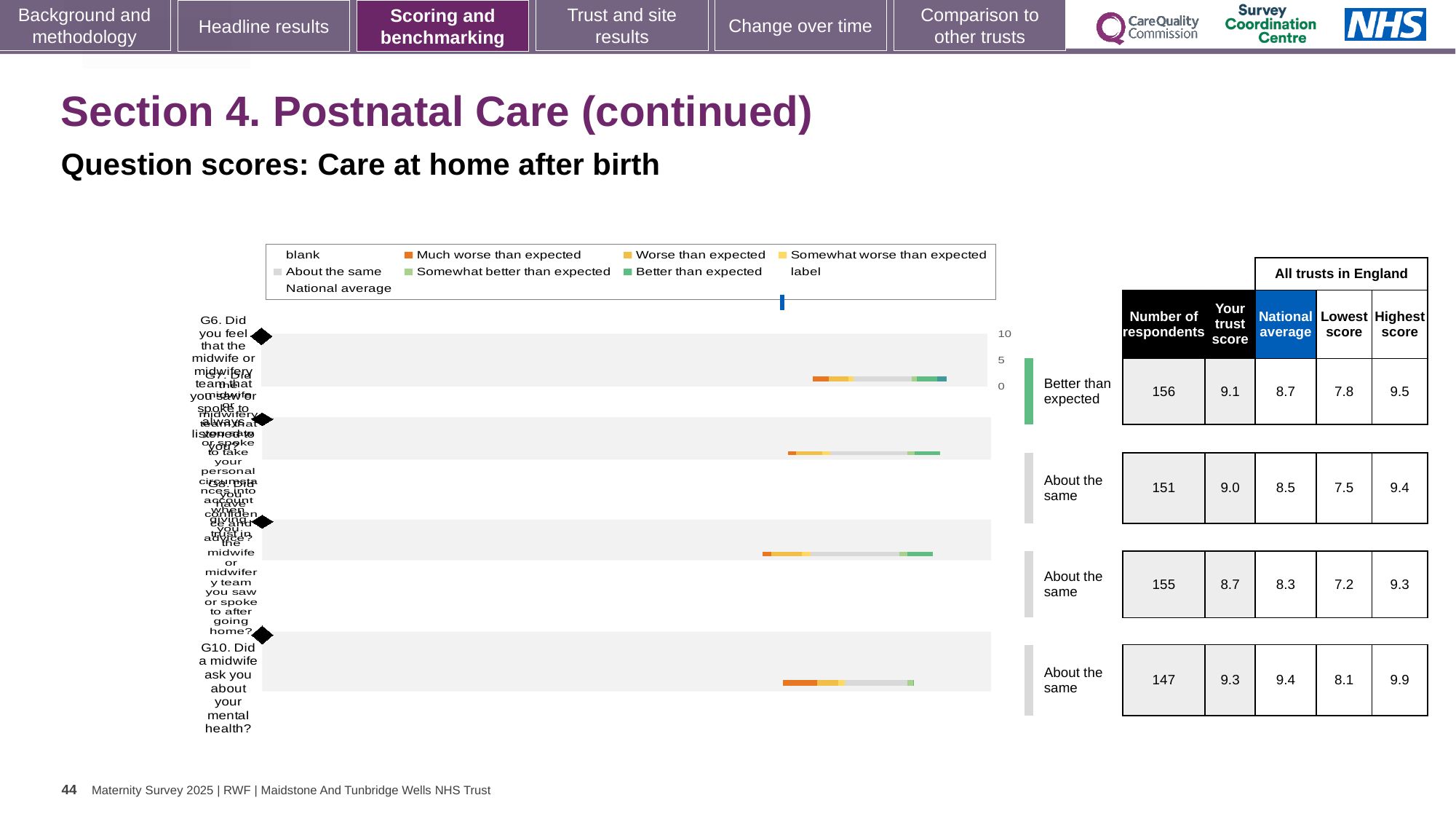
How many questions (rows) are plotted in the chart? 4 What kind of chart is shown on the slide? bar chart What is the national average for G10 (Did a midwife ask you about your mental health?)? 9.4 For the first row (G6), what is the difference between the trust score and the national average? 0.4 What is the trust score for G10 (Did a midwife ask you about your mental health?)? 9.3 What is the number of respondents for G10 (Did a midwife ask you about your mental health?)? 147 What is the lowest 'Your trust score' shown in the table? 8.7 Which row has the highest 'Your trust score'? G10 (the bottom row), 9.3 What benchmark category is given for the first row (G6)? Better than expected How many rows are rated 'About the same'? 3 For the first row (G6), which is larger: the trust score or the national average? the trust score (9.1) What is the highest score across all trusts in England for G10? 9.9